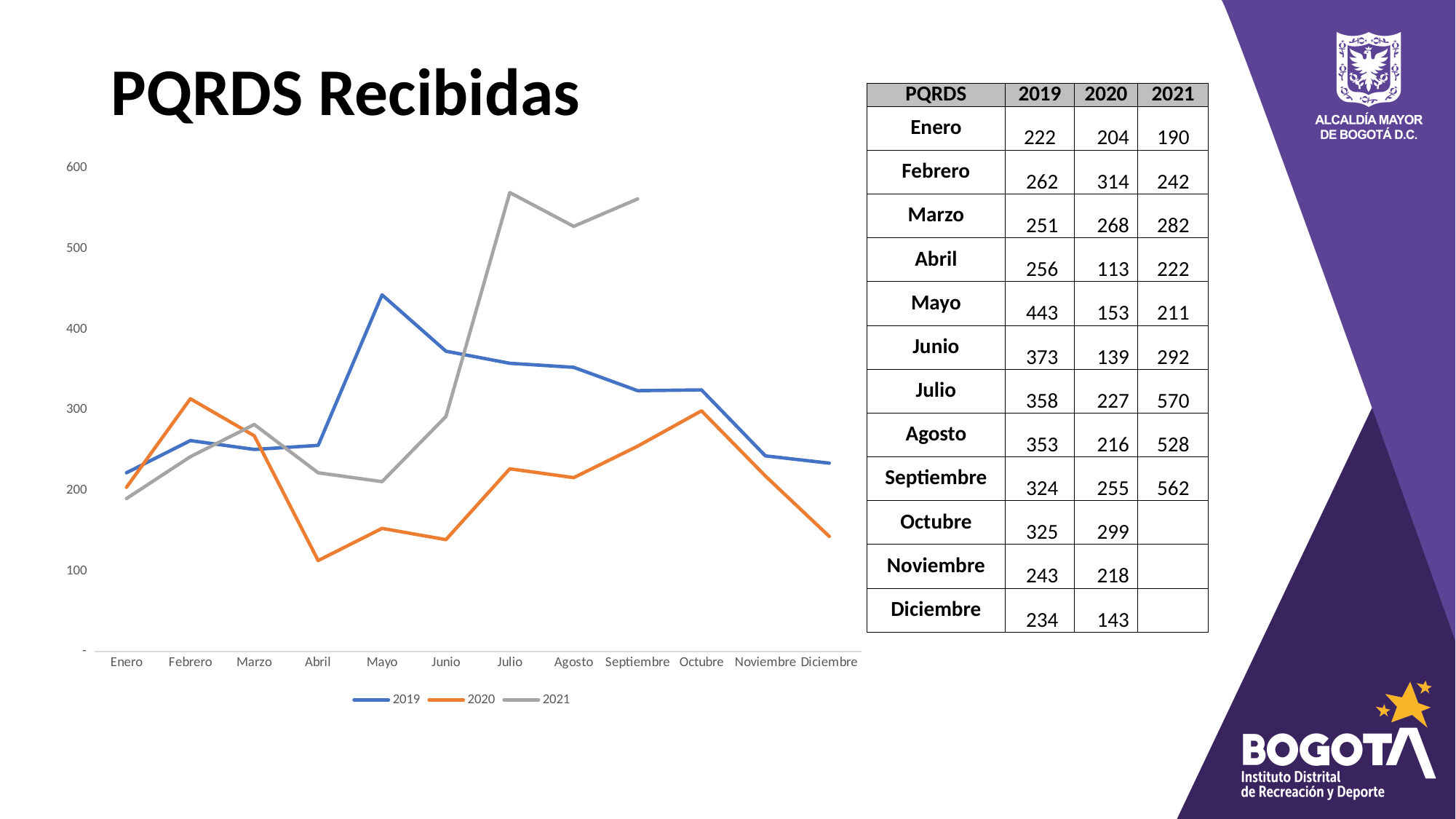
How many months are shown along the x axis of the chart? 12 What is the difference between the 2021 and 2020 values for Julio? 343 According to the table, what was the value for Julio in 2021? 570 Does the 2020 line rise or fall from Octubre to Diciembre? fall According to the table, what was the value for Mayo in 2019? 443 In which month does the 2019 line reach its highest value? Mayo Is the 2021 value for Agosto greater or less than 500? greater What kind of chart is shown on the slide? line chart Which is larger, the 2019 value for Junio or the 2020 value for Junio? 2019 According to the table, what was the value for Abril in 2020? 113 How many series does the chart legend list? 3 In which month does the 2020 line reach its lowest value? Abril